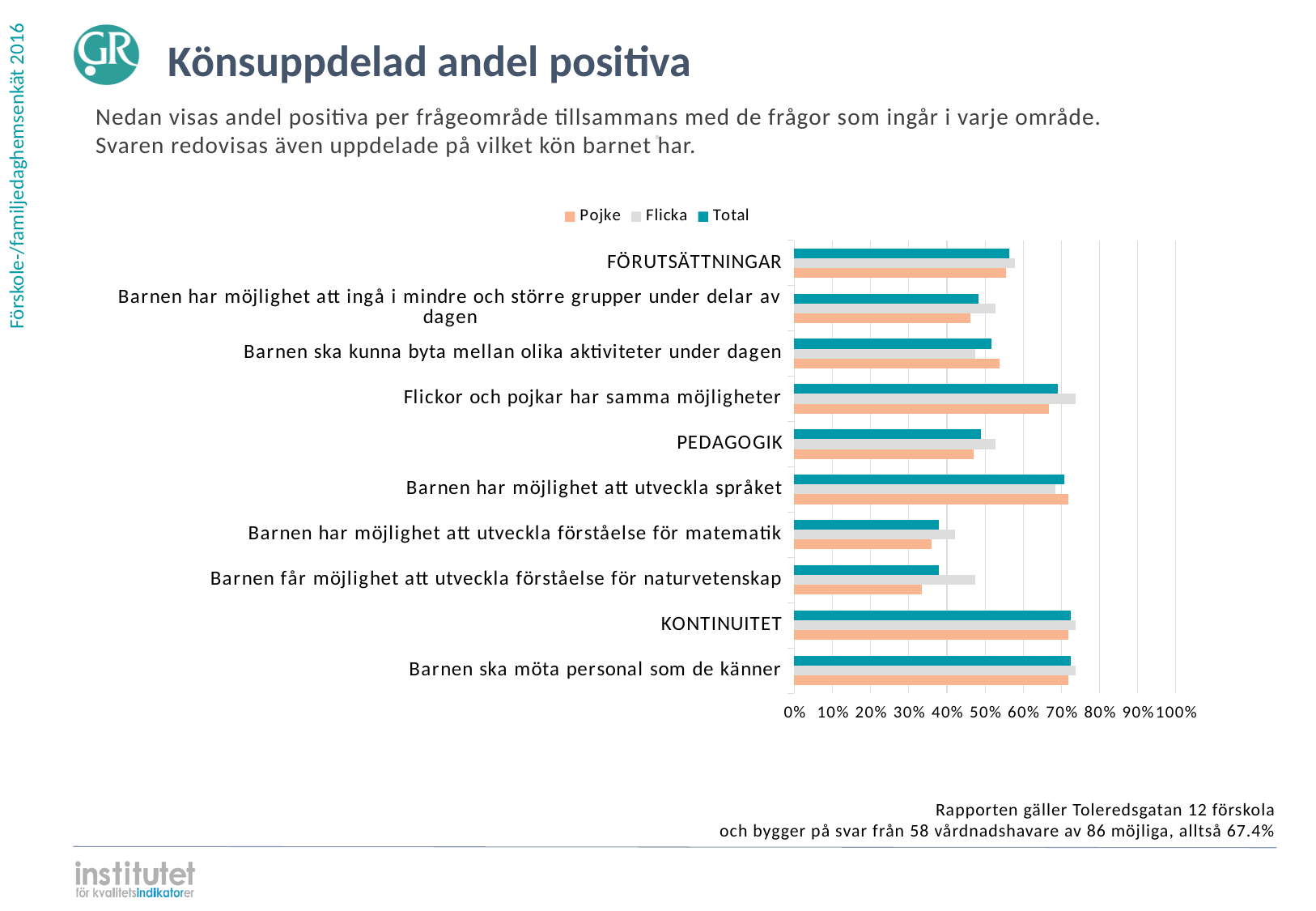
What kind of chart is shown on the slide? bar chart Is the Pojke value for 'Barnen har möjlighet att ingå i mindre och större grupper under delar av dagen' greater or less than 50%? less How many series does the legend list? 3 How many categories are plotted on the y axis of the chart? 10 Is the Pojke value for KONTINUITET greater or less than 60%? greater Which series are listed in the chart legend? Pojke, Flicka, Total For 'Barnen får möjlighet att utveckla förståelse för naturvetenskap', which is larger, the Pojke value or the Flicka value? Flicka Which is larger, the Total value for 'Flickor och pojkar har samma möjligheter' or the Total value for PEDAGOGIK? Flickor och pojkar har samma möjligheter For 'Flickor och pojkar har samma möjligheter', which is larger, the Pojke value or the Flicka value? Flicka Is the Total value for 'Barnen har möjlighet att utveckla språket' greater or less than 60%? greater